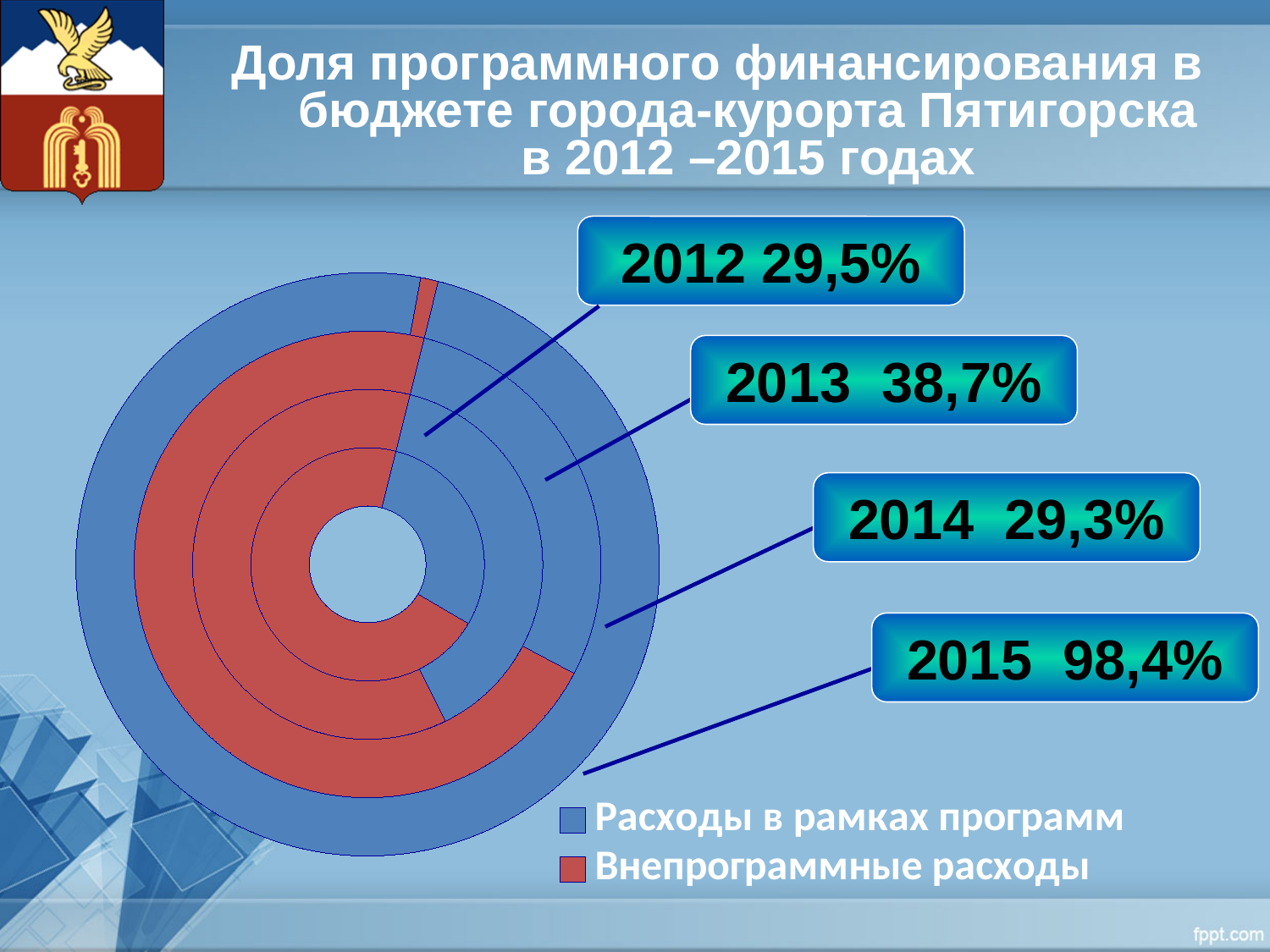
What kind of chart is shown on the slide? Doughnut chart What is the difference between the 2013 and 2012 shares of program financing? 9,2 How many years (rings) does the chart show? 4 What share of program financing is shown for 2015? 98,4% By how many percentage points does the 2015 share exceed the 2014 share? 69,1 What share of program financing is shown for 2012? 29,5% What share of program financing is shown for 2013? 38,7% What share of program financing is shown for 2014? 29,3% Which year has the lowest share of program financing? 2014 How many series does the legend list? 2 Which year has the highest share of program financing? 2015 Which year has a larger share of program financing, 2013 or 2012? 2013